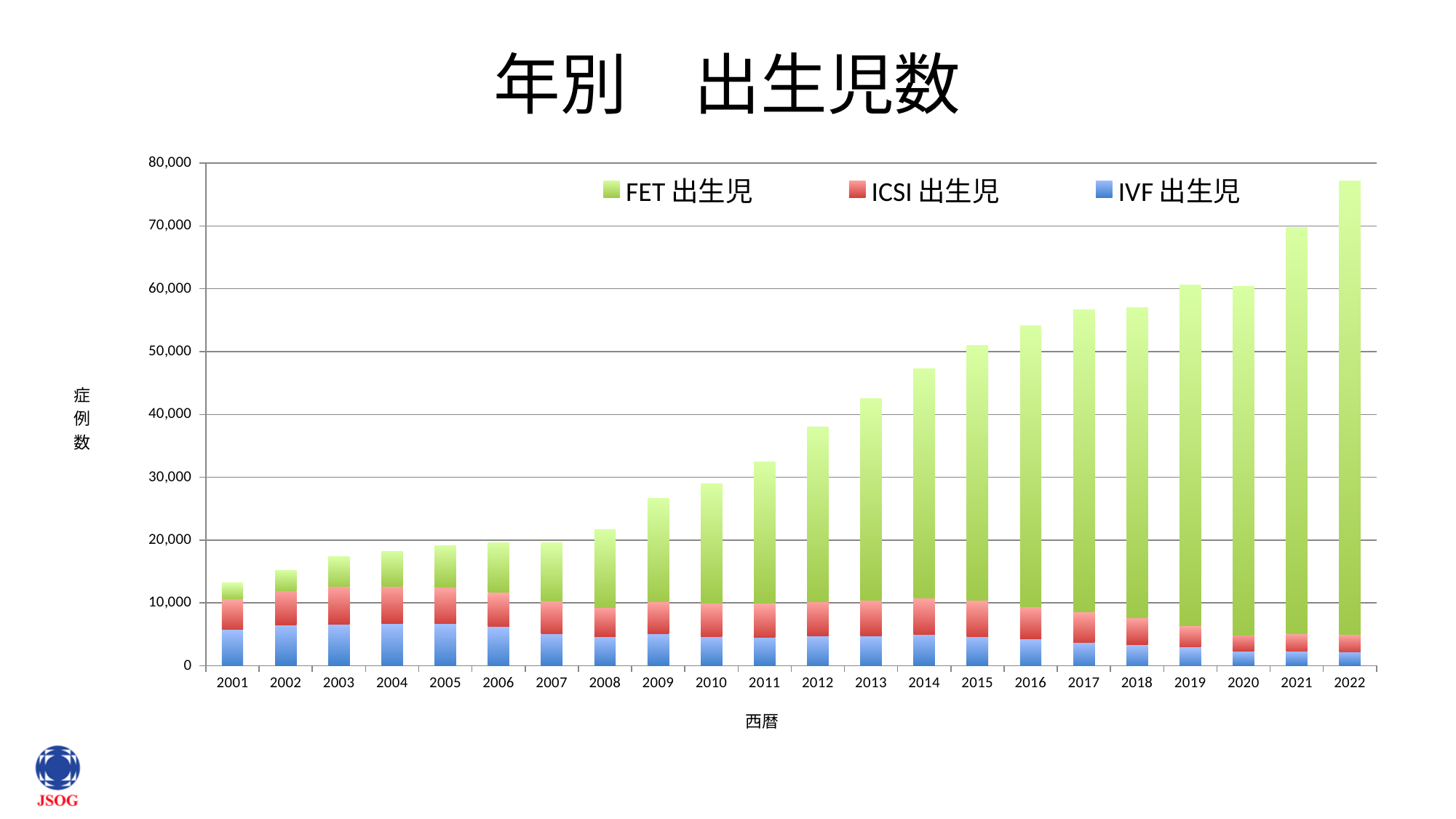
Is the total value for 2009 greater or less than 30,000? less Is the total value for 2008 greater or less than 20,000? greater Is the total value for 2016 greater or less than 50,000? greater How many series does the legend list? 3 What is the title of the chart? 年別 出生児数 How many years are shown along the x axis? 22 Which year has the highest total number of births? 2022 What kind of chart is shown on the slide? Stacked bar chart Which year has a larger total, 2013 or 2014? 2014 Do the total values generally rise or fall from 2001 to 2022? rise Which year has the lowest total number of births? 2001